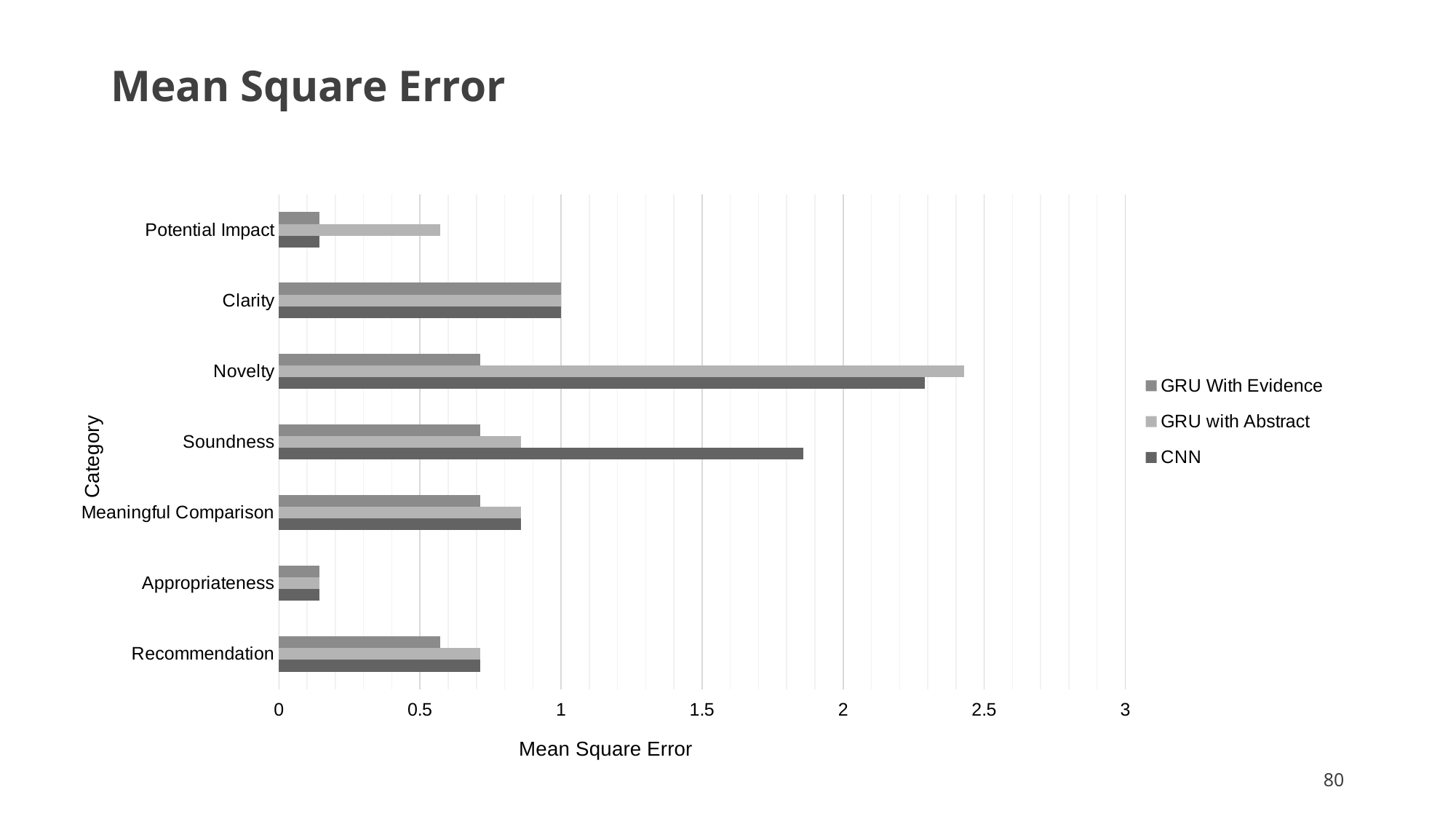
What is the Mean Square Error value for CNN in the Clarity category? 1 How many categories are listed on the y axis of the chart? 7 Is the GRU with Abstract value for Novelty greater or less than 2? greater For the Potential Impact category, which is larger: the GRU with Abstract value or the GRU With Evidence value? GRU with Abstract What kind of chart is shown on the slide? bar chart Which category has the highest GRU with Abstract value? Novelty Which category has the highest CNN value? Novelty How many series does the legend list? 3 Is the CNN value for Soundness greater or less than 1.5? greater Is the CNN value for Appropriateness greater or less than 0.5? less Which category has the highest GRU With Evidence value? Clarity What is the title of the x axis? Mean Square Error